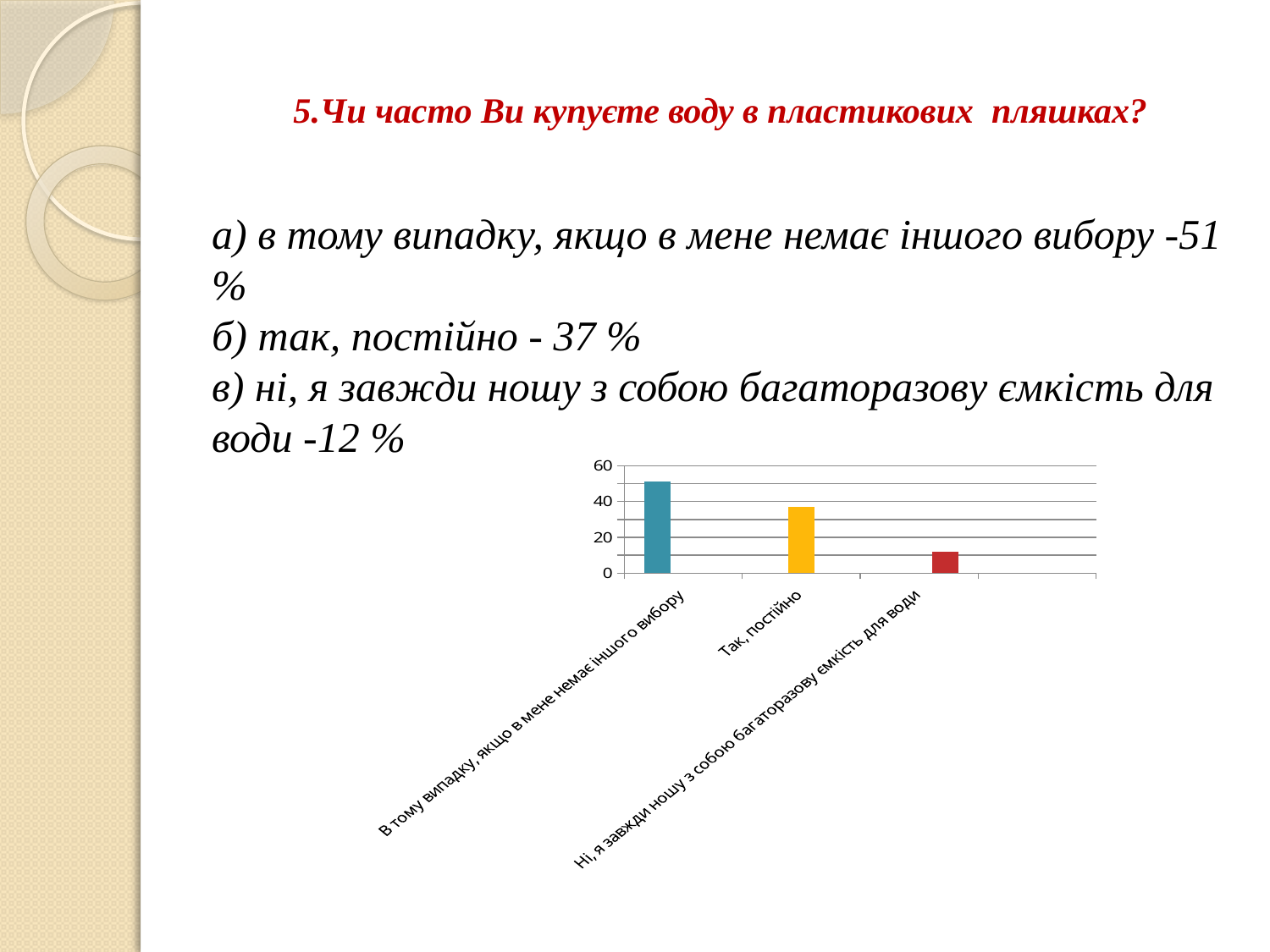
Which is larger: the bar for "Так, постійно" or the bar for "Ні, я завжди ношу з собою багаторазову ємкість для води"? Так, постійно Is the bar for "В тому випадку, якщо в мене немає іншого вибору" greater or less than 40? greater Is the bar for "Так, постійно" greater or less than 40? less Is the bar for "Ні, я завжди ношу з собою багаторазову ємкість для води" greater or less than 20? less According to the slide, what percentage corresponds to "Так, постійно"? 37 % Do the bar values rise or fall from left to right across the chart? fall What kind of chart is shown on the slide? bar chart Which category has the lowest bar in the chart? Ні, я завжди ношу з собою багаторазову ємкість для води Which category has the highest bar in the chart? В тому випадку, якщо в мене немає іншого вибору How many bars (categories) does the chart have? 3 According to the slide, what percentage corresponds to "Ні, я завжди ношу з собою багаторазову ємкість для води"? 12 % What colour is the bar for "Так, постійно"? yellow